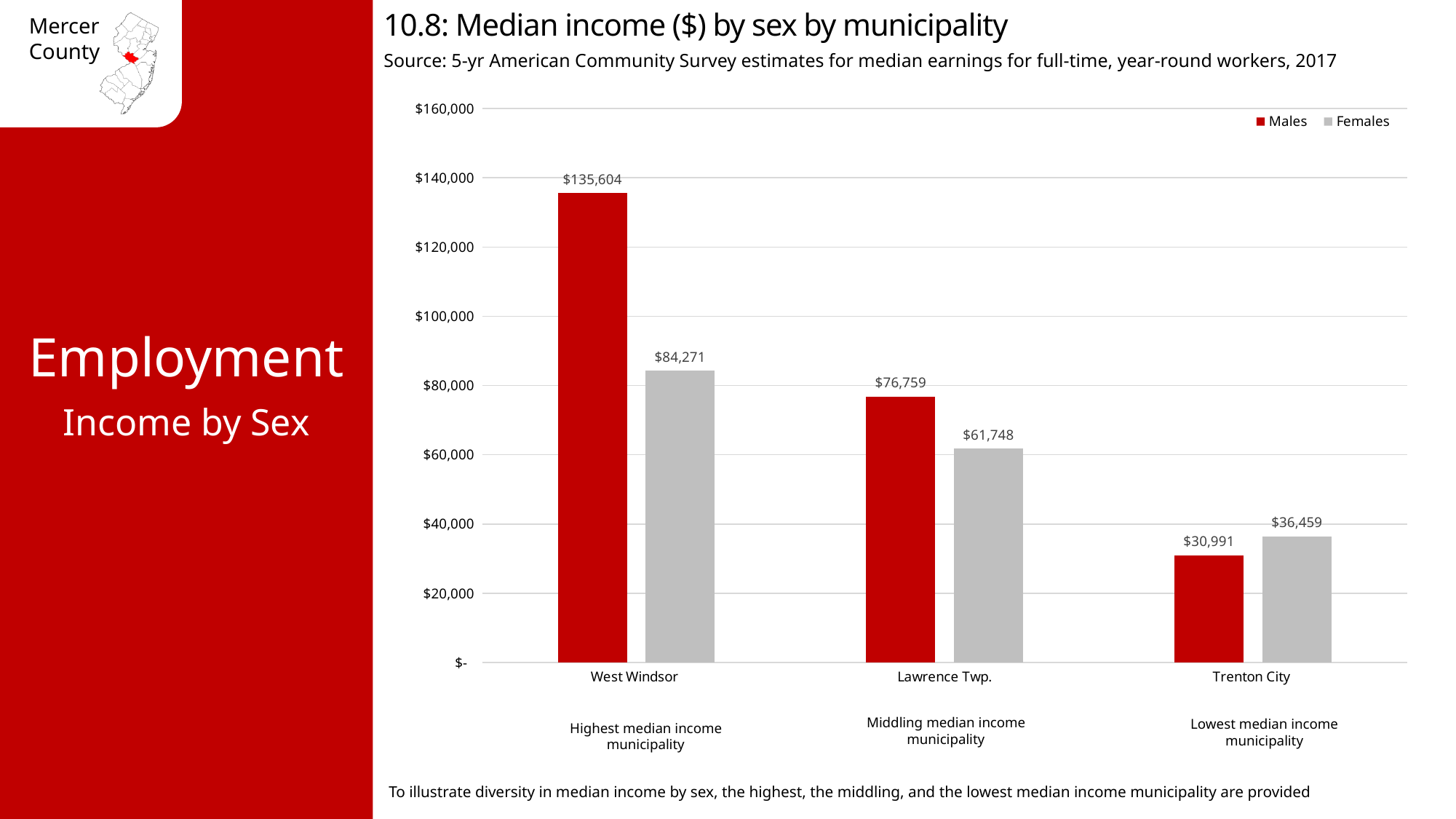
Is the Males median income in Lawrence Twp. greater or less than $80,000? less What is the median income for Males in West Windsor? $135,604 How many municipalities are shown on the chart? 3 How many series does the legend list? 2 What is the median income for Females in Trenton City? $36,459 Which municipality has the highest median income for Males? West Windsor What is the difference between the Females and Males median income in Trenton City? $5,468 What is the difference between the Males and Females median income in West Windsor? $51,333 What is the median income for Females in Lawrence Twp.? $61,748 What kind of chart is shown on the slide? bar chart Which municipality has the lowest median income for Females? Trenton City In Trenton City, which is larger: the Males or the Females median income? Females